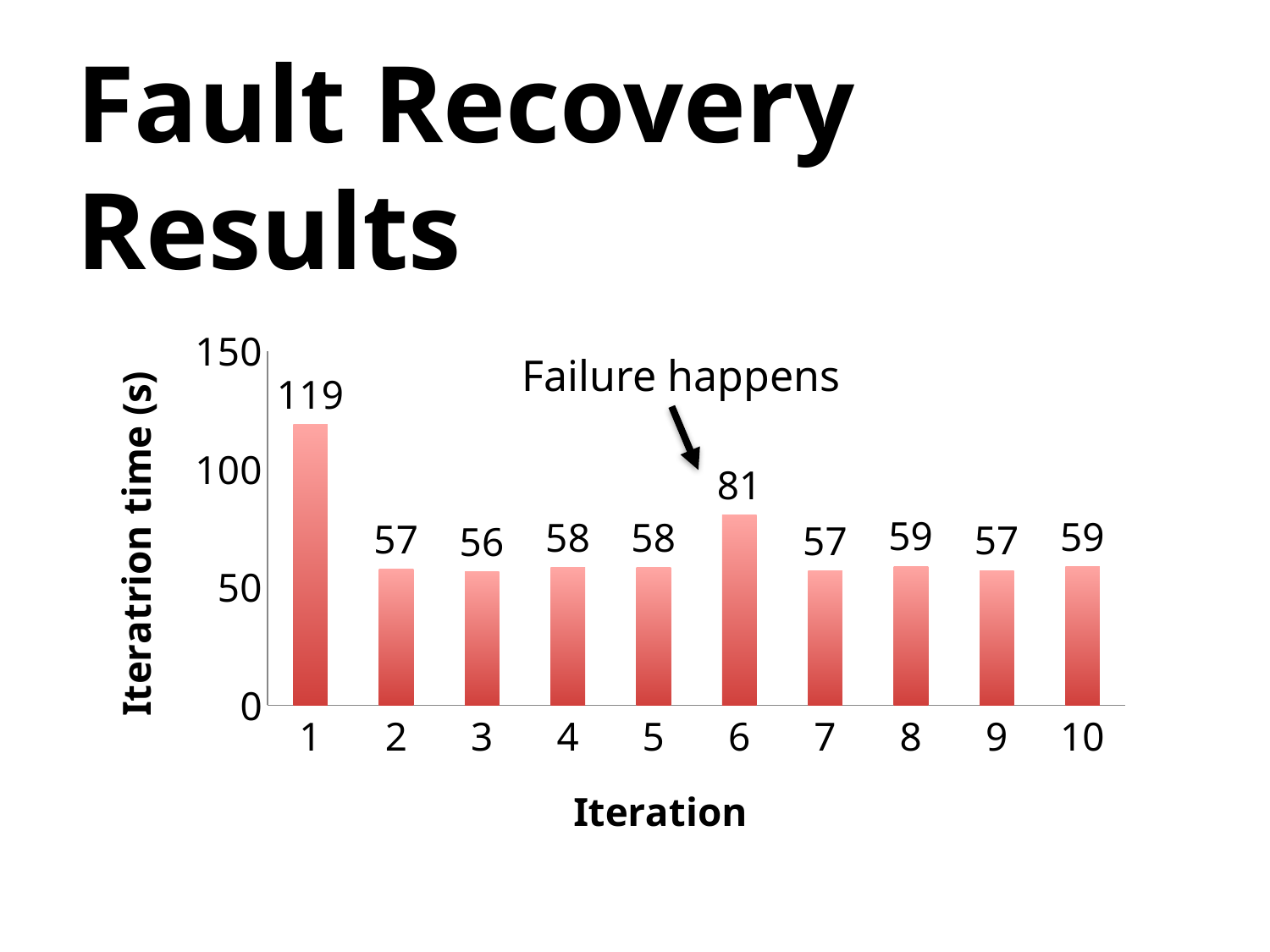
What is the difference in iteration time between iteration 1 and iteration 6? 38 How many iterations are shown on the x axis? 10 Which iteration has the lowest iteration time? 3 What kind of chart is shown on the slide? Bar chart Which iteration has the highest iteration time? 1 Is the iteration time for iteration 1 greater or less than 100? greater Which has a larger iteration time, iteration 6 or iteration 10? Iteration 6 What is the iteration time for iteration 1? 119 What is the iteration time for iteration 6? 81 What is the iteration time for iteration 3? 56 What is the difference in iteration time between iteration 6 and iteration 7? 24 Which iteration does the 'Failure happens' annotation point to? 6